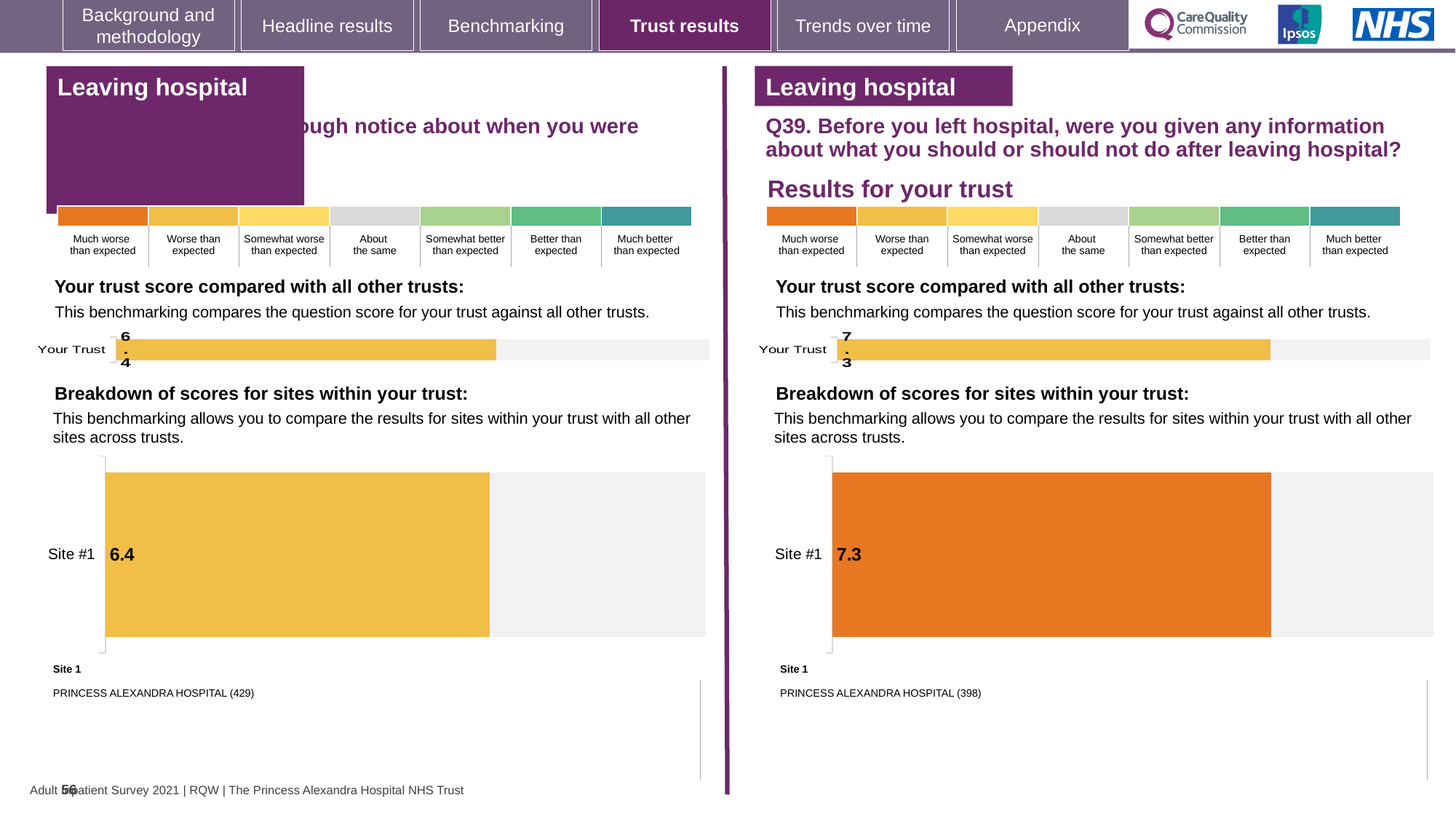
What is the difference between the Site #1 score on the right-hand (Q39) breakdown chart and the Site #1 score on the left-hand breakdown chart? 0.9 On the right-hand (Q39) 'Your trust score compared with all other trusts' chart, what is the score for Your Trust? 7.3 Which site is listed as Site 1 beneath the right-hand (Q39) breakdown chart? PRINCESS ALEXANDRA HOSPITAL (398) How many sites are shown on the right-hand (Q39) 'Breakdown of scores for sites within your trust' chart? 1 What type of chart is used to show the Site #1 score on the right-hand (Q39) breakdown chart? Bar chart Which is larger: the Your Trust score on the left-hand chart or the Your Trust score on the right-hand (Q39) chart? Right-hand (Q39) chart On the right-hand (Q39) 'Breakdown of scores for sites within your trust' chart, what is the score for Site #1? 7.3 According to the colour key, which benchmark category does the orange colour of the Site #1 bar on the right-hand (Q39) breakdown chart represent? Much worse than expected On the left-hand 'Your trust score compared with all other trusts' chart, what is the score for Your Trust? 6.4 On the left-hand 'Breakdown of scores for sites within your trust' chart, what is the score for Site #1? 6.4 How many sites are shown on the left-hand 'Breakdown of scores for sites within your trust' chart? 1